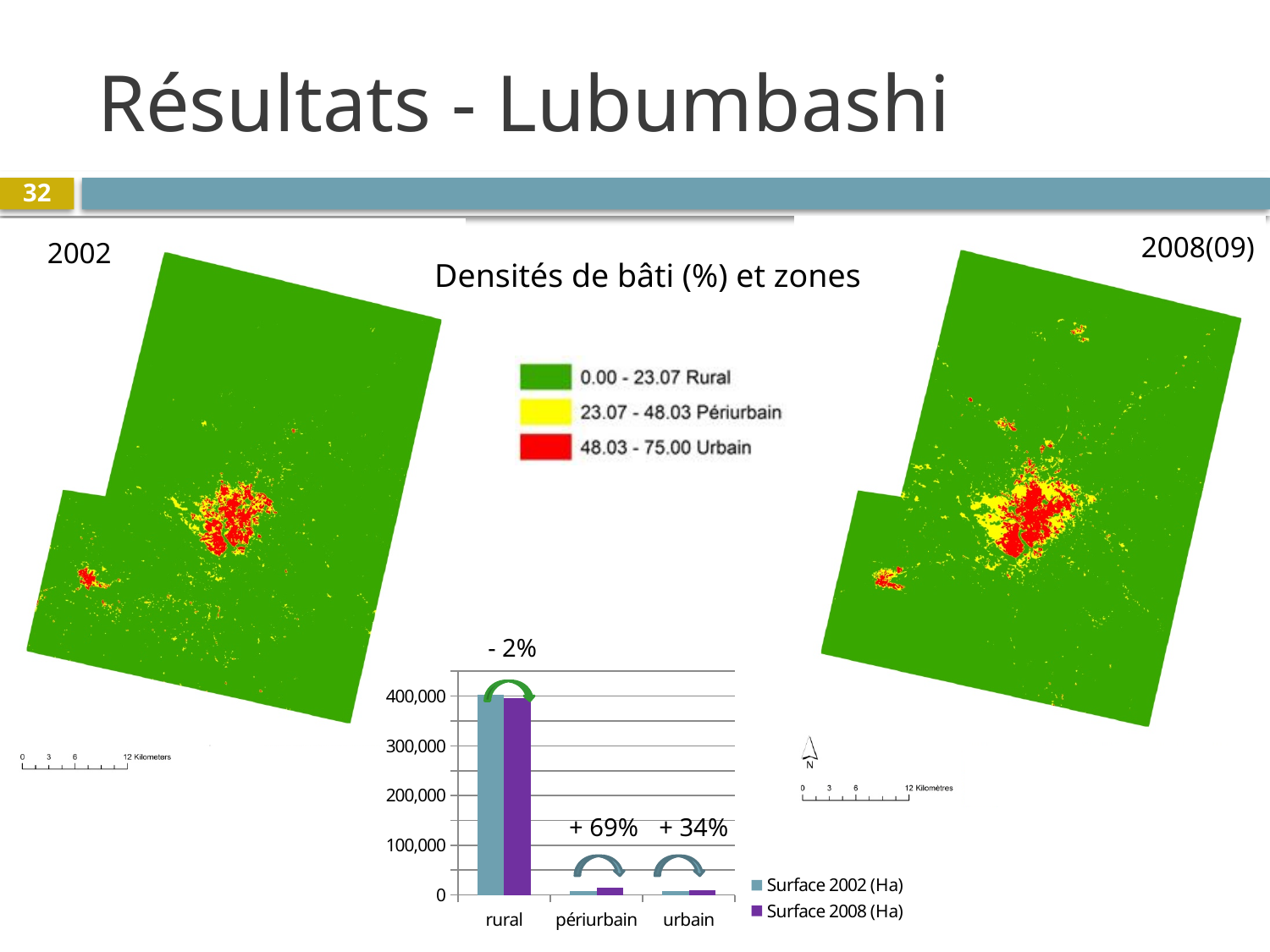
What kind of chart is shown at the bottom of the slide? bar chart What percentage change is annotated above the urbain bars in the bar chart? + 34% Is the value for Surface 2002 (Ha) in the rural category greater or less than 300,000? greater What percentage change is annotated above the rural bars in the bar chart? - 2% Which is larger in the bar chart: Surface 2002 (Ha) for rural or Surface 2002 (Ha) for urbain? rural What percentage change is annotated above the périurbain bars in the bar chart? + 69% Which category has the highest bars in the bar chart? rural How many categories are shown on the x axis of the bar chart? 3 In the périurbain category, which is larger: Surface 2002 (Ha) or Surface 2008 (Ha)? Surface 2008 (Ha) Is the value for Surface 2008 (Ha) in the urbain category greater or less than 100,000? less Is the value for Surface 2008 (Ha) in the périurbain category greater or less than 100,000? less How many series does the legend of the bar chart list? 2